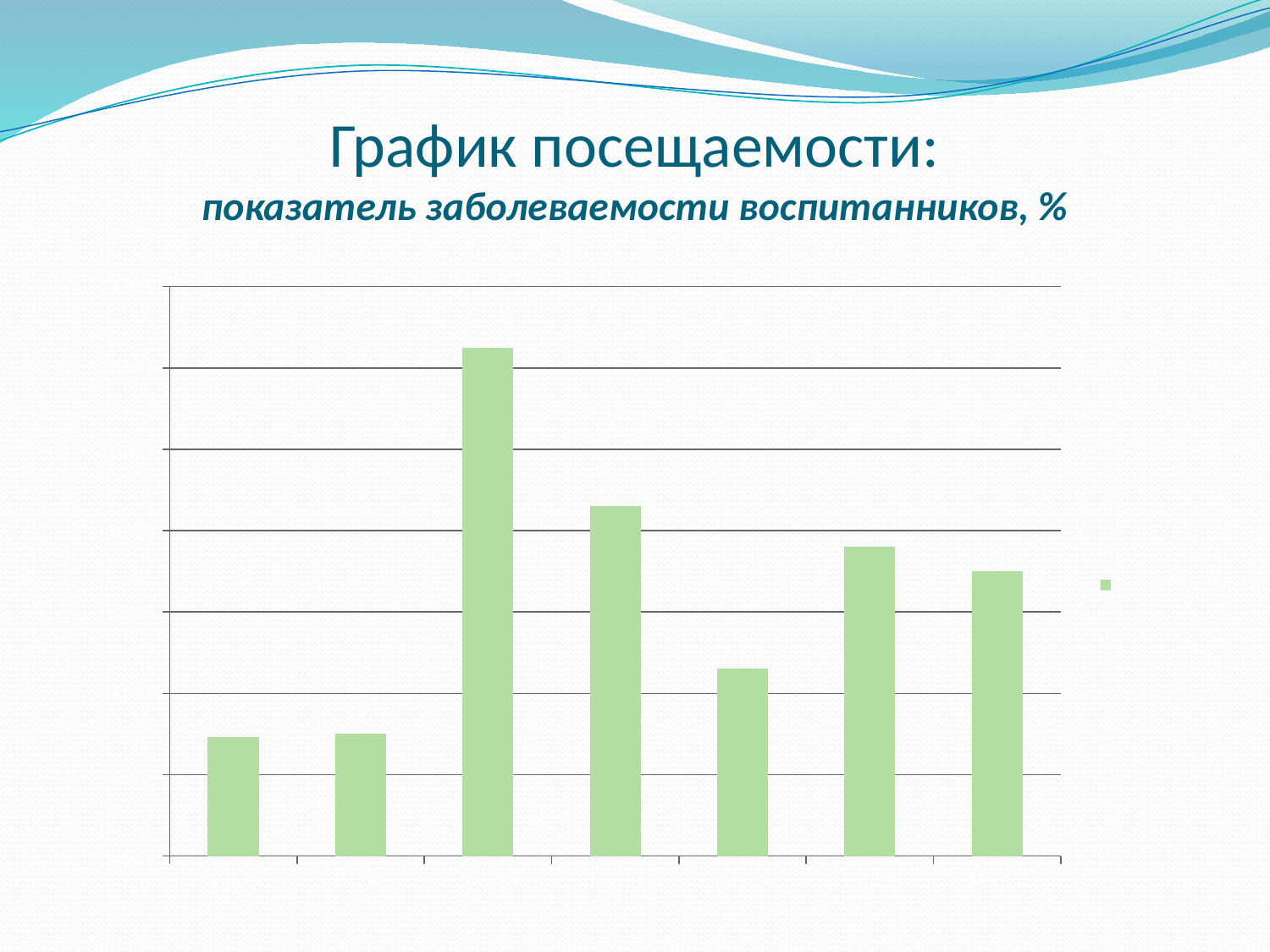
Which bar, counting from the left, is the tallest in the chart? the third bar Do the bar values rise or fall from the first bar to the third bar? rise Which is taller: the fourth bar from the left or the fifth bar from the left? the fourth bar What colour are the bars in the chart? light green Which is taller: the fifth bar from the left or the sixth bar from the left? the sixth bar Which is taller: the third bar from the left or the fourth bar from the left? the third bar Do the bar values rise or fall from the third bar to the fifth bar? fall What kind of chart is shown on the slide? bar chart What is the main title of the chart slide? График посещаемости: How many bars are plotted in the chart? 7